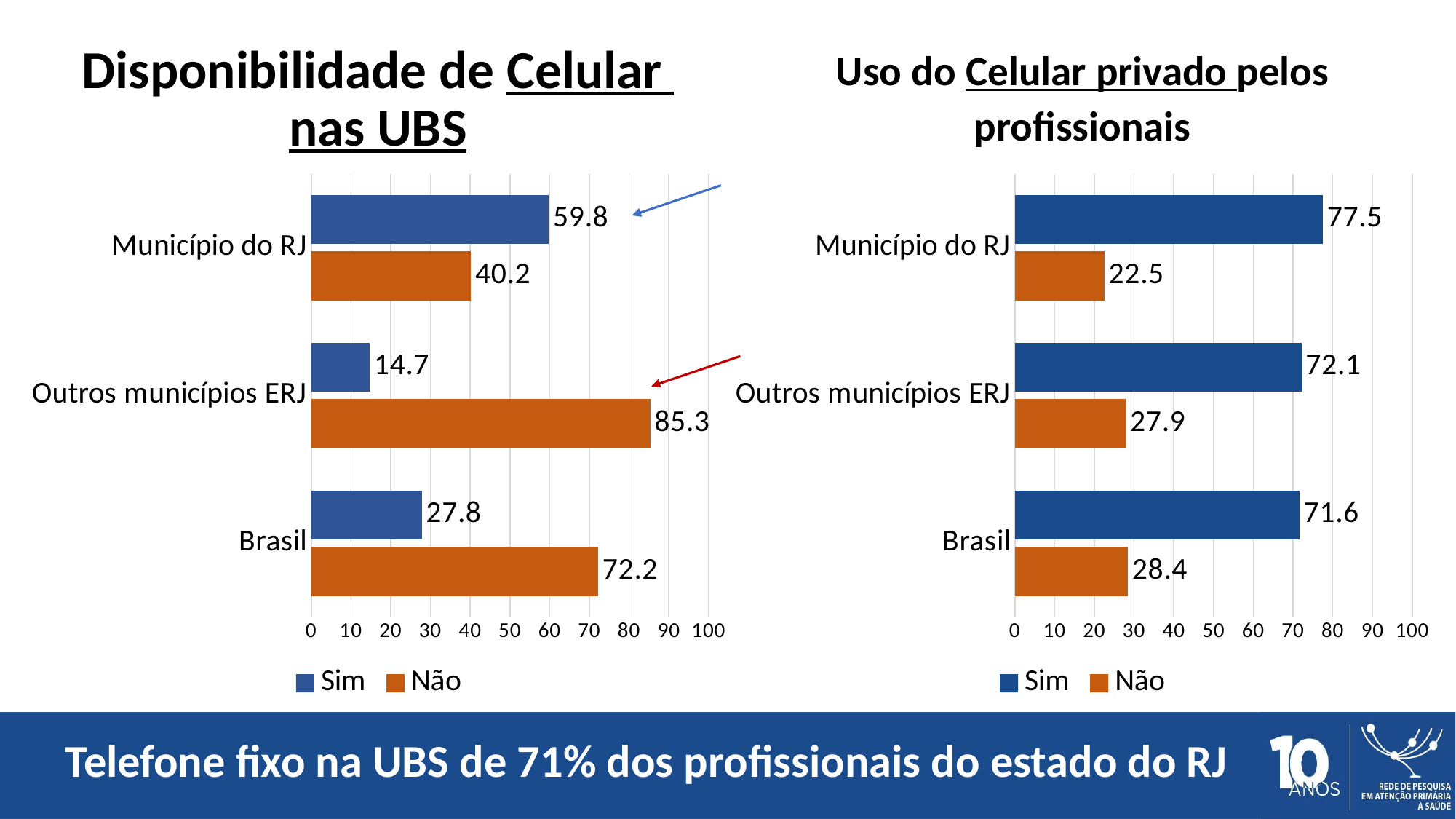
In the 'Uso do Celular privado pelos profissionais' chart, what is the 'Não' value for Município do RJ? 22.5 In the 'Uso do Celular privado pelos profissionais' chart, which category has the highest 'Sim' value? Município do RJ In the 'Disponibilidade de Celular nas UBS' chart, what is the 'Não' value for Outros municípios ERJ? 85.3 What type of chart is the 'Uso do Celular privado pelos profissionais' chart? Bar chart In the 'Uso do Celular privado pelos profissionais' chart, what is the 'Sim' value for Brasil? 71.6 How many categories are shown on the y axis of the 'Disponibilidade de Celular nas UBS' chart? 3 In the 'Uso do Celular privado pelos profissionais' chart, is the 'Não' value for Brasil larger or smaller than the 'Não' value for Outros municípios ERJ? larger In the 'Disponibilidade de Celular nas UBS' chart, which category has the lowest 'Sim' value? Outros municípios ERJ In the 'Disponibilidade de Celular nas UBS' chart, which category has the highest 'Sim' value? Município do RJ In the 'Disponibilidade de Celular nas UBS' chart, what is the 'Sim' value for Município do RJ? 59.8 In the 'Disponibilidade de Celular nas UBS' chart, what is the difference between the 'Não' and 'Sim' values for Brasil? 44.4 How many series does the legend of the 'Uso do Celular privado pelos profissionais' chart list? 2